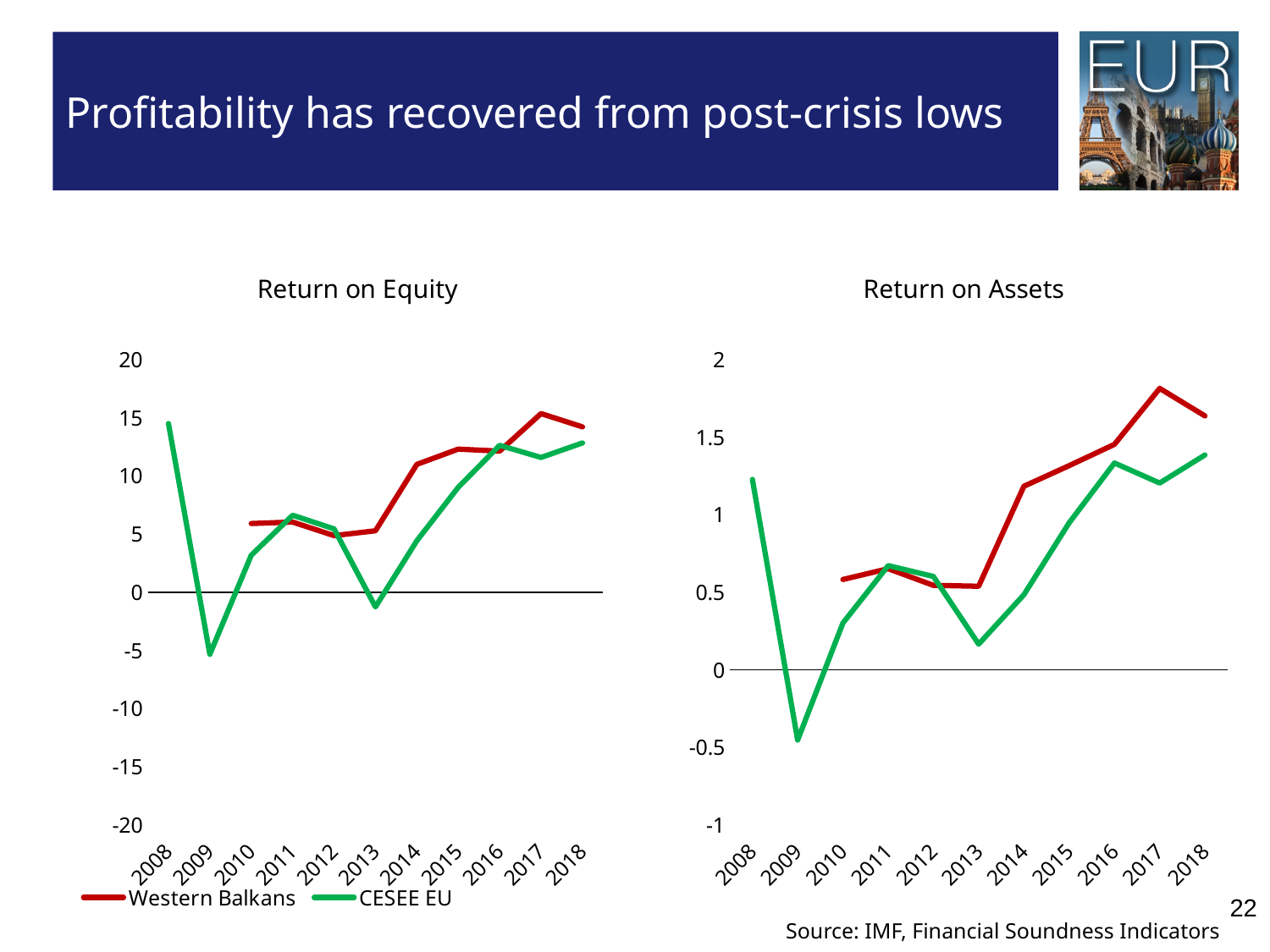
In the Return on Assets chart, is the Western Balkans value for 2017 greater or less than 1.5? greater What kind of chart is the Return on Equity chart? line chart In the Return on Equity chart, which year has the lowest CESEE EU value? 2009 What colour is the Western Balkans line? red In the Return on Equity chart, which series has the larger value in 2014, Western Balkans or CESEE EU? Western Balkans How many years are shown on the x axis of the Return on Assets chart? 11 In the Return on Assets chart, is the CESEE EU value for 2013 greater or less than 0.5? less In the Return on Equity chart, is the CESEE EU value for 2009 greater or less than 0? less How many series does the legend list? 2 In the Return on Assets chart, which year has the highest Western Balkans value? 2017 In the Return on Assets chart, does the Western Balkans line rise or fall from 2013 to 2017? rise